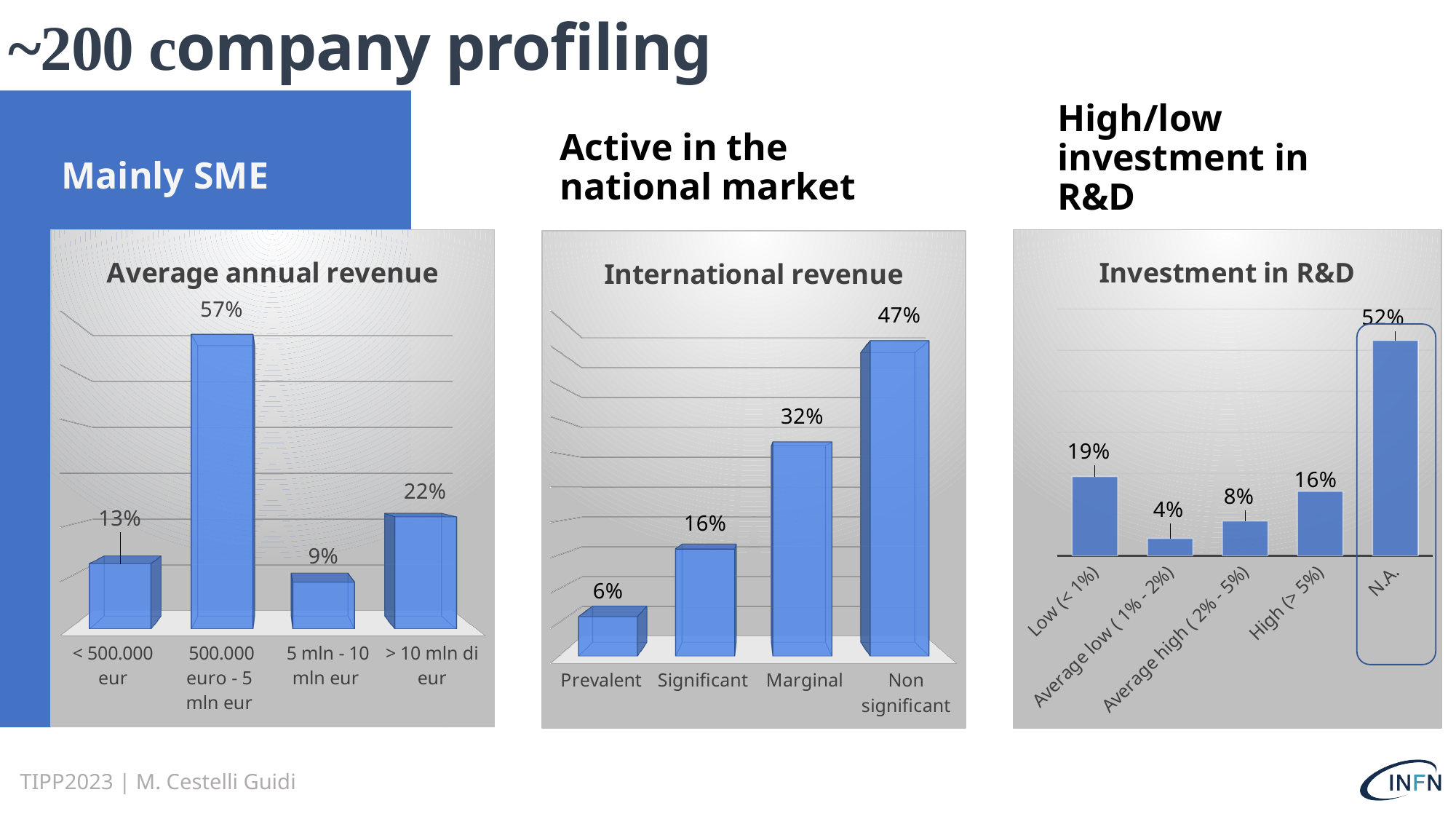
In the 'International revenue' chart, which category has the highest value? Non significant How many categories are shown in the 'Investment in R&D' chart? 5 In the 'Average annual revenue' chart, what is the difference between the values for '> 10 mln di eur' and '< 500.000 eur'? 9% In the 'International revenue' chart, what is the value for 'Marginal'? 32% In the 'International revenue' chart, what is the difference between 'Non significant' and 'Prevalent'? 41% In the 'International revenue' chart, do the values rise or fall from left to right along the x axis? rise In the 'Average annual revenue' chart, what is the value for '500.000 euro - 5 mln eur'? 57% In the 'Investment in R&D' chart, what is the value for 'Average low (1% - 2%)'? 4% In the 'Average annual revenue' chart, which category has the lowest value? 5 mln - 10 mln eur In the 'Investment in R&D' chart, which is larger: 'Low (< 1%)' or 'High (> 5%)'? Low (< 1%) What kind of chart is the 'Investment in R&D' chart? bar chart How many categories are shown in the 'Average annual revenue' chart? 4